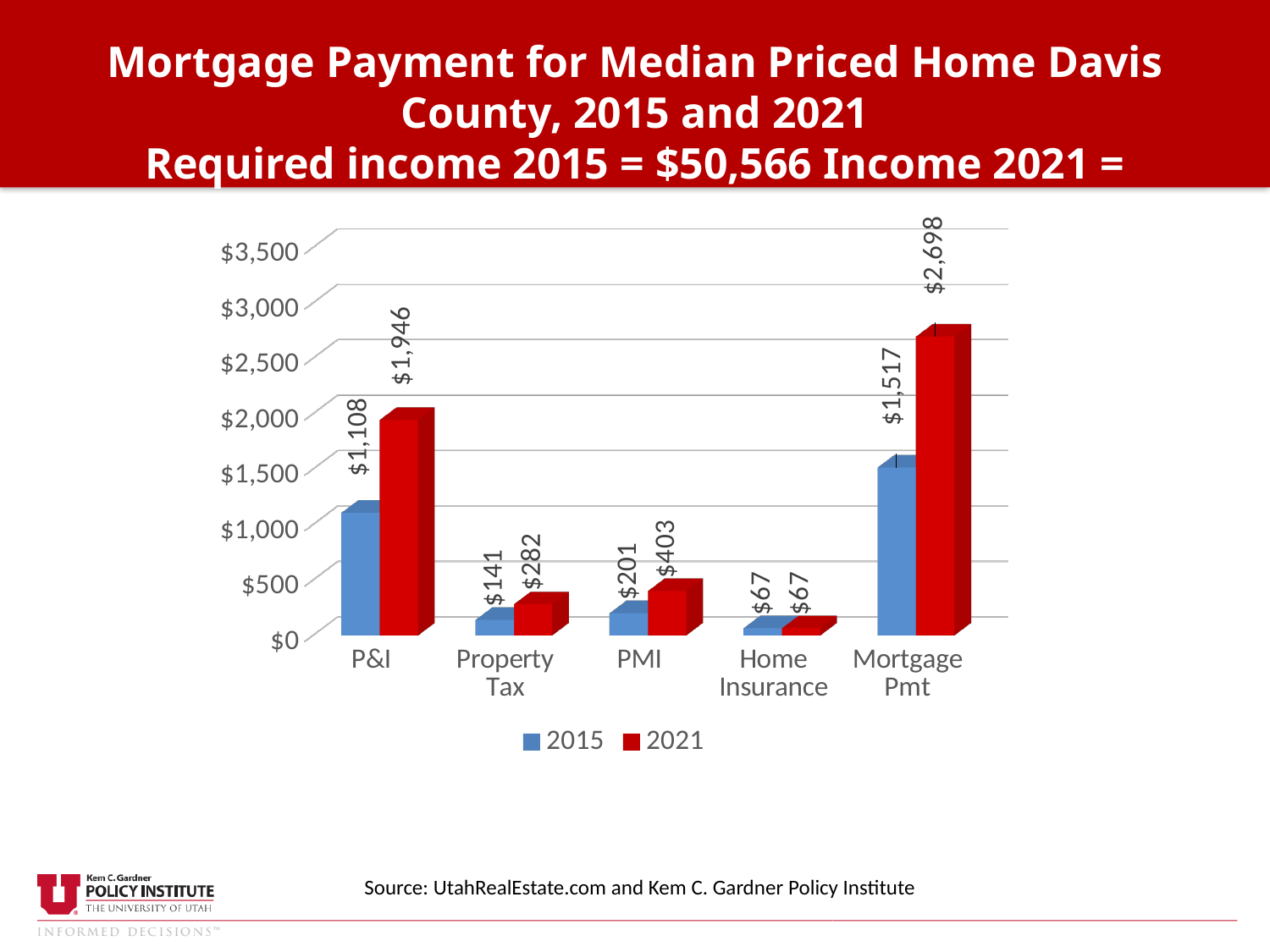
Which category has the highest 2021 value? Mortgage Pmt What is the 2015 value for Mortgage Pmt? $1,517 What is the 2015 value for PMI? $201 How many categories are shown on the x axis? 5 Which is larger, the 2021 value for PMI or the 2021 value for Property Tax? 2021 value for PMI What is the difference between the 2021 and 2015 values for P&I? $838 What is the difference between the 2021 and 2015 values for Mortgage Pmt? $1,181 How many series does the legend list? 2 Which category has the lowest 2015 value? Home Insurance What is the 2021 value for P&I? $1,946 What is the 2021 value for Property Tax? $282 What kind of chart is shown on the slide? Bar chart